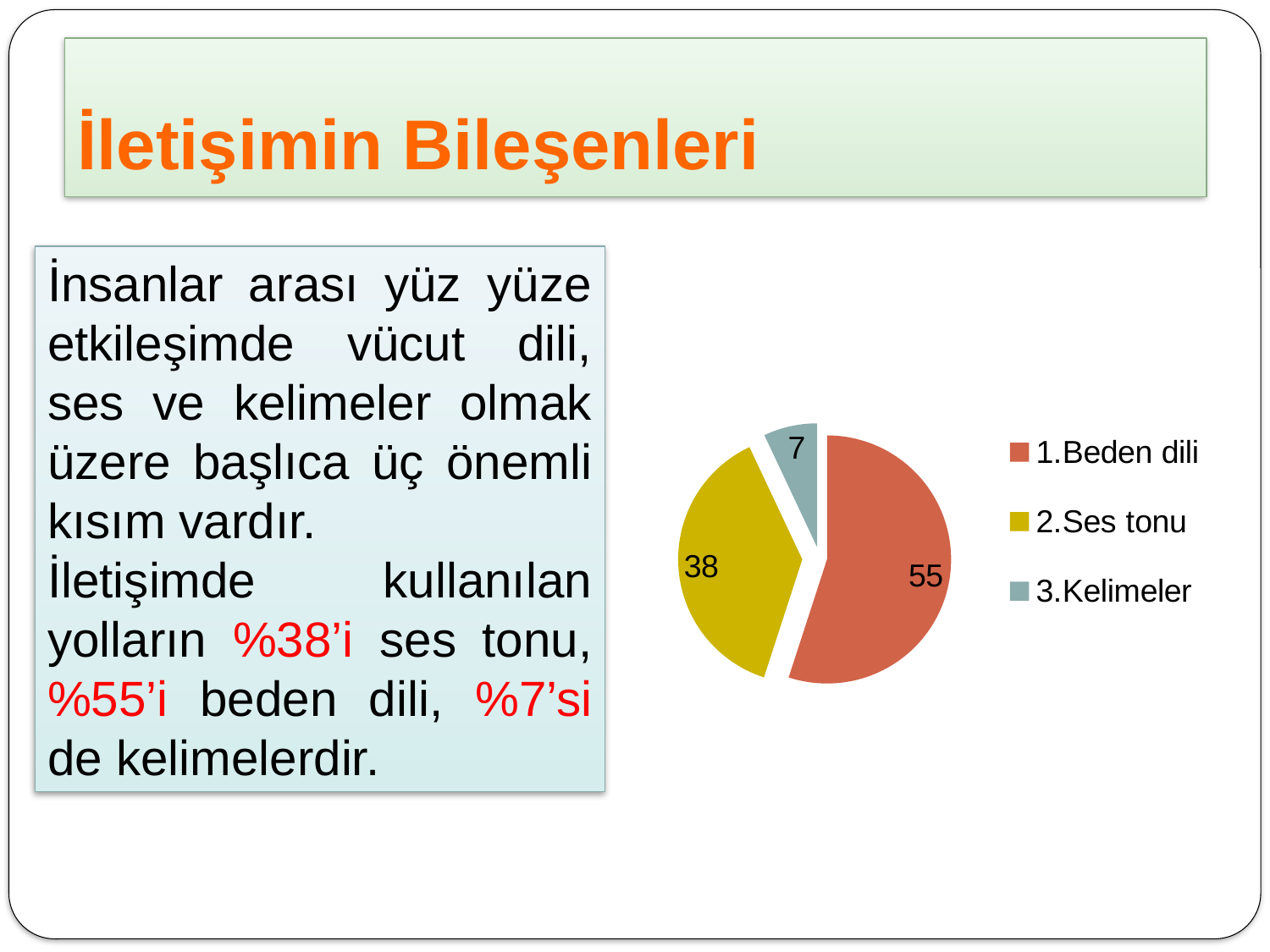
Which category has the smallest slice? 3.Kelimeler Which is larger, the value for 2.Ses tonu or the value for 3.Kelimeler? 2.Ses tonu What is the difference between the values for 1.Beden dili and 2.Ses tonu? 17 Which category has the largest slice? 1.Beden dili What colour is the slice for 2.Ses tonu? yellow How many entries does the legend list? 3 What kind of chart is shown on the slide? pie chart What is the value for 2.Ses tonu? 38 How many slices does the pie chart have? 3 What is the value for 1.Beden dili? 55 What is the difference between the values for 2.Ses tonu and 3.Kelimeler? 31 What is the value for 3.Kelimeler? 7